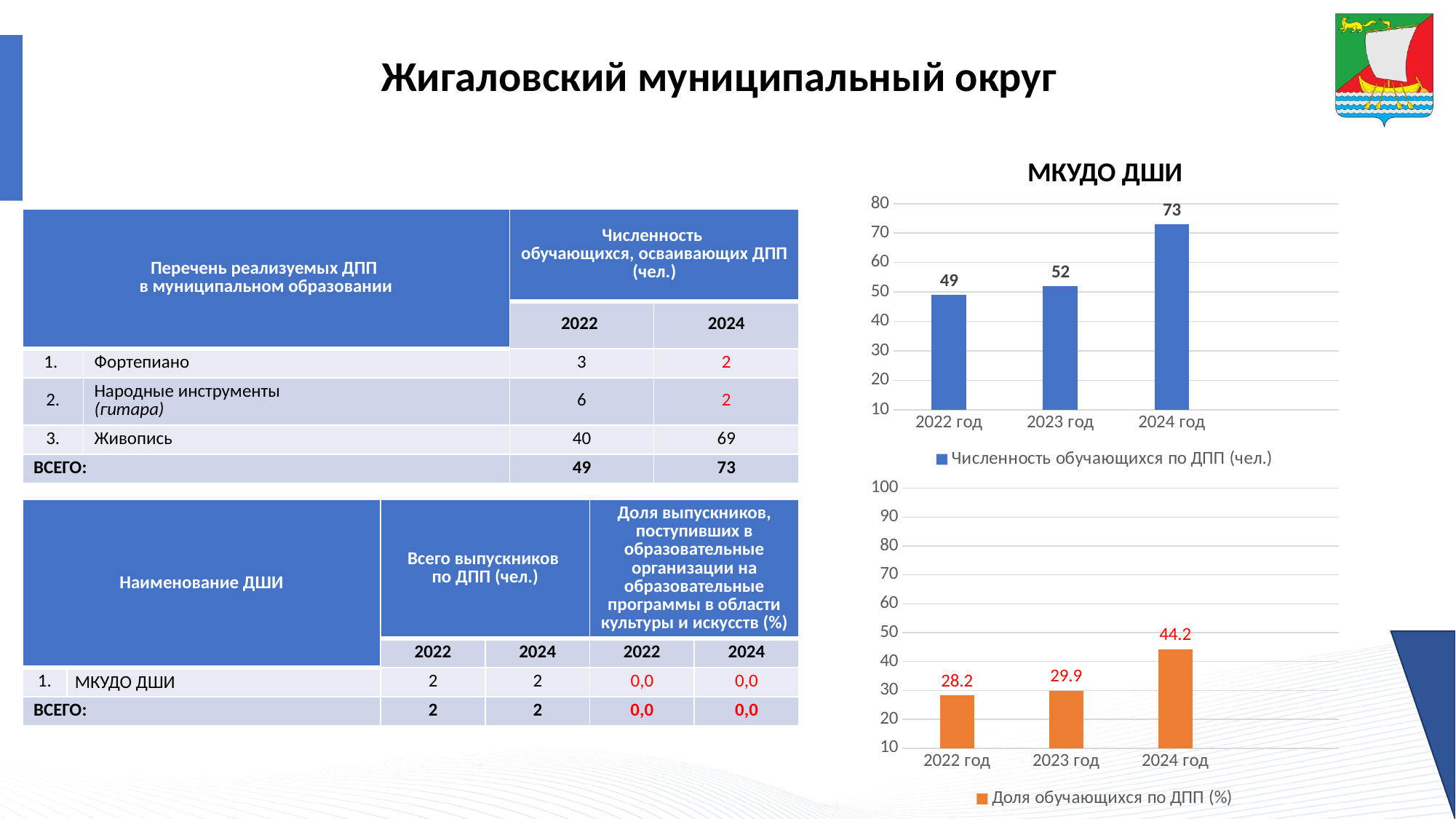
In the bottom chart on the right (orange bars), what is the difference between the values for 2024 год and 2022 год? 16.0 In the top chart titled МКУДО ДШИ, what is the value for 2022 год? 49 In the bottom chart on the right (orange bars), what is the value for 2024 год? 44.2 In the bottom chart on the right (orange bars), how many years are shown on the x axis? 3 In the top chart titled МКУДО ДШИ, which year has the highest value? 2024 год In the top chart titled МКУДО ДШИ, what is the difference between the values for 2024 год and 2023 год? 21 What kind of chart is the top chart titled МКУДО ДШИ? bar chart In the top chart titled МКУДО ДШИ, what is the value for 2024 год? 73 In the bottom chart on the right (orange bars), which year has the highest value? 2024 год In the top chart titled МКУДО ДШИ, which year has the lowest value? 2022 год In the bottom chart on the right (orange bars), what is the value for 2023 год? 29.9 In the top chart titled МКУДО ДШИ, do the values rise or fall from 2022 год to 2024 год? rise